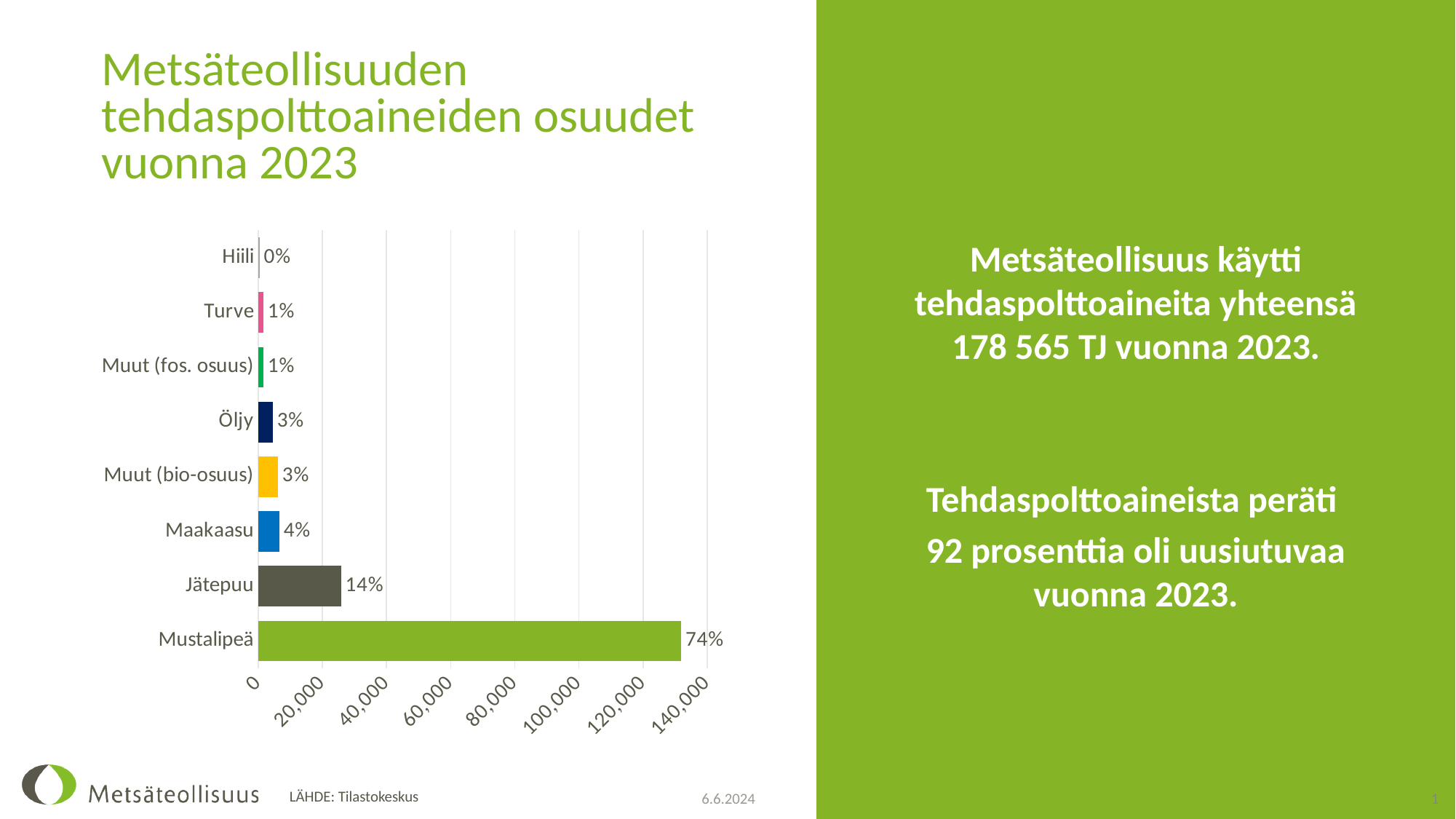
Is the bar for Jätepuu greater or less than 40,000 on the axis? less Which category has the highest value in the chart? Mustalipeä Is the bar for Mustalipeä greater or less than 120,000 on the axis? greater What kind of chart is shown on the slide? bar chart What is the data label shown for Hiili? 0% What is the data label shown for Maakaasu? 4% What is the difference in percentage points between the labels for Mustalipeä and Jätepuu? 60 percentage points Which is larger, the value for Jätepuu or the value for Maakaasu? Jätepuu What is the data label shown for Jätepuu? 14% Which category has the lowest value in the chart? Hiili How many categories are shown in the chart? 8 What is the data label shown for Mustalipeä? 74%